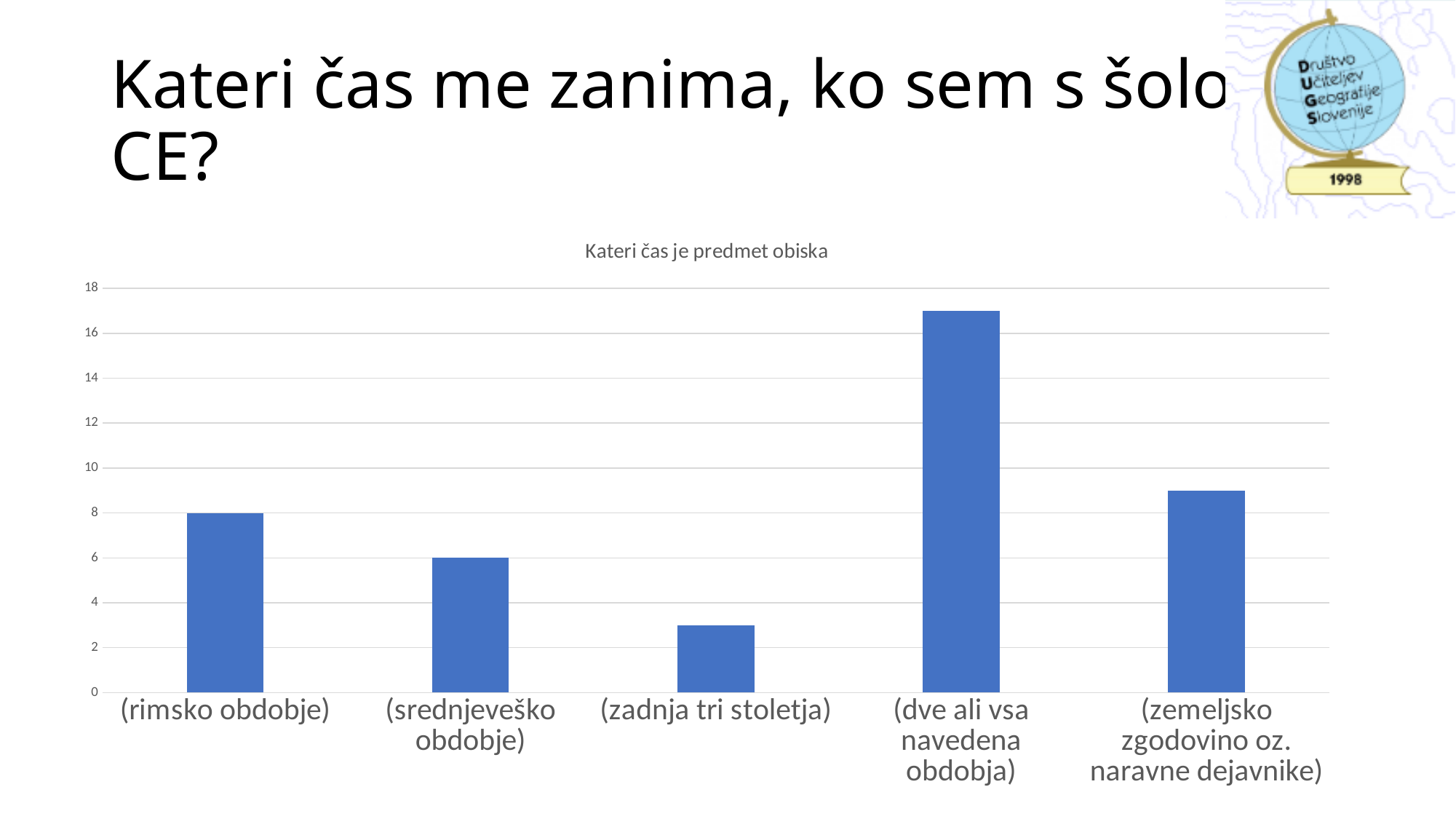
What is the difference between the values for (rimsko obdobje) and (srednjeveško obdobje)? 2 Which category has the highest bar? (dve ali vsa navedena obdobja) Which category has the lowest bar? (zadnja tri stoletja) Is the value for (zadnja tri stoletja) greater or less than 4? less Which is larger, the value for (rimsko obdobje) or the value for (srednjeveško obdobje)? (rimsko obdobje) What is the value for (rimsko obdobje)? 8 How many categories are shown on the x axis of the chart? 5 What is the title of the chart? Kateri čas je predmet obiska What is the value for (srednjeveško obdobje)? 6 What type of chart is shown on the slide? bar chart Is the value for (zemeljsko zgodovino oz. naravne dejavnike) greater or less than 10? less Is the value for (dve ali vsa navedena obdobja) greater or less than 16? greater